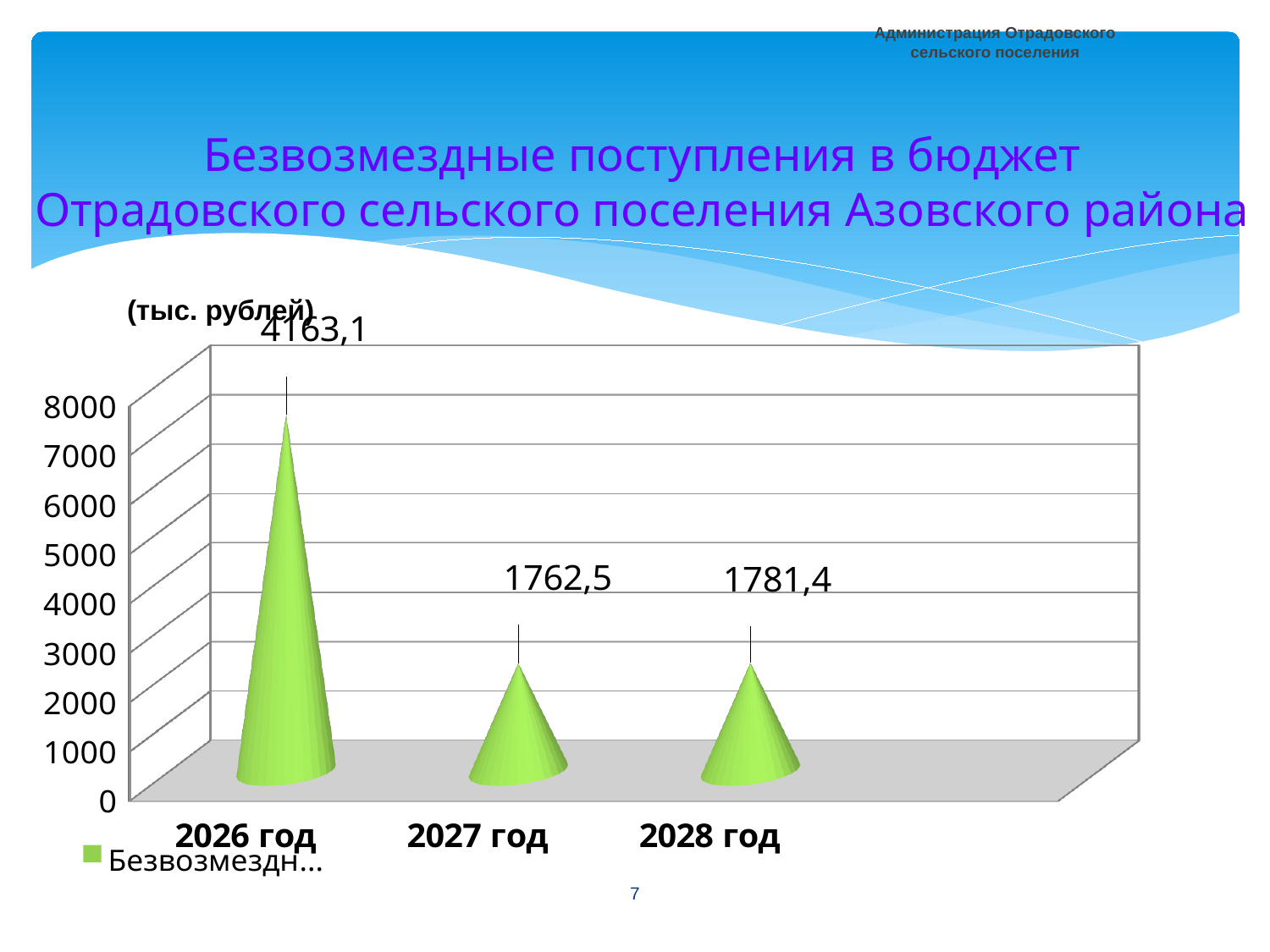
What is the value for 2027 год? 1762,5 What is the difference between the values for 2028 год and 2027 год? 18,9 Which year has the lowest value? 2027 год What kind of chart is shown on the slide? bar chart What is the value for 2026 год? 4163,1 Do the values rise or fall from 2026 год to 2027 год? fall What is the value for 2028 год? 1781,4 Which year has the highest value? 2026 год How many years are shown on the x axis? 3 How many series does the legend list? 1 What is the difference between the values for 2026 год and 2027 год? 2400,6 Which is larger, the value for 2026 год or the value for 2028 год? 2026 год